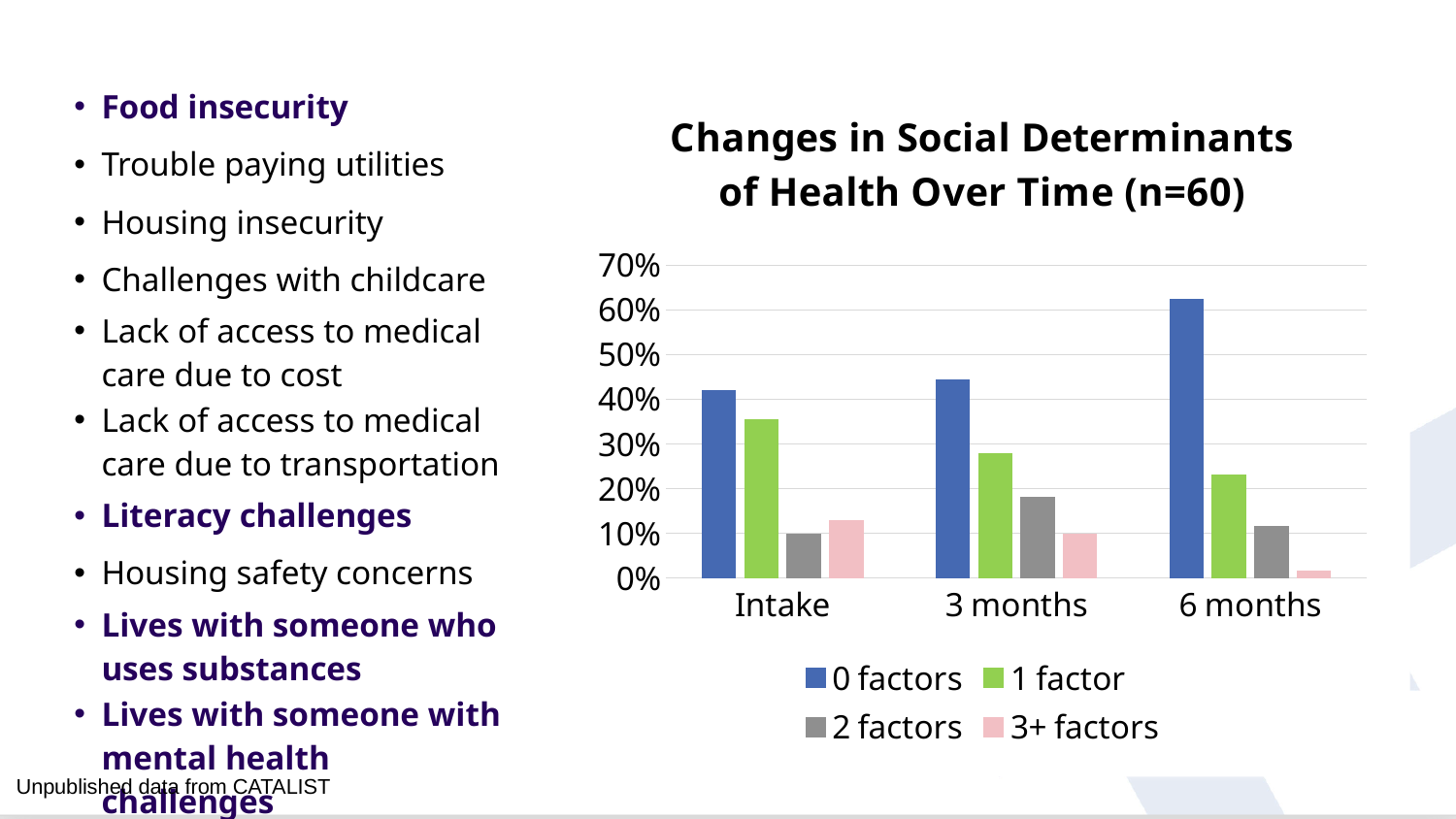
How many time points are shown on the x axis of the chart? 3 Is the value for 0 factors at 6 months greater or less than 60%? greater Which is larger at 3 months: the value for 1 factor or the value for 2 factors? 1 factor Which series is shown in pink in the chart? 3+ factors Does the value for 1 factor rise or fall from Intake to 6 months? fall What is the title of the chart? Changes in Social Determinants of Health Over Time (n=60) Which time point has the highest value for 0 factors? 6 months What type of chart is shown on the slide? bar chart How many series does the chart legend list? 4 Is the value for 3+ factors at 6 months greater or less than 10%? less Is the value for 1 factor at Intake greater or less than 30%? greater Which time point has the lowest value for 3+ factors? 6 months